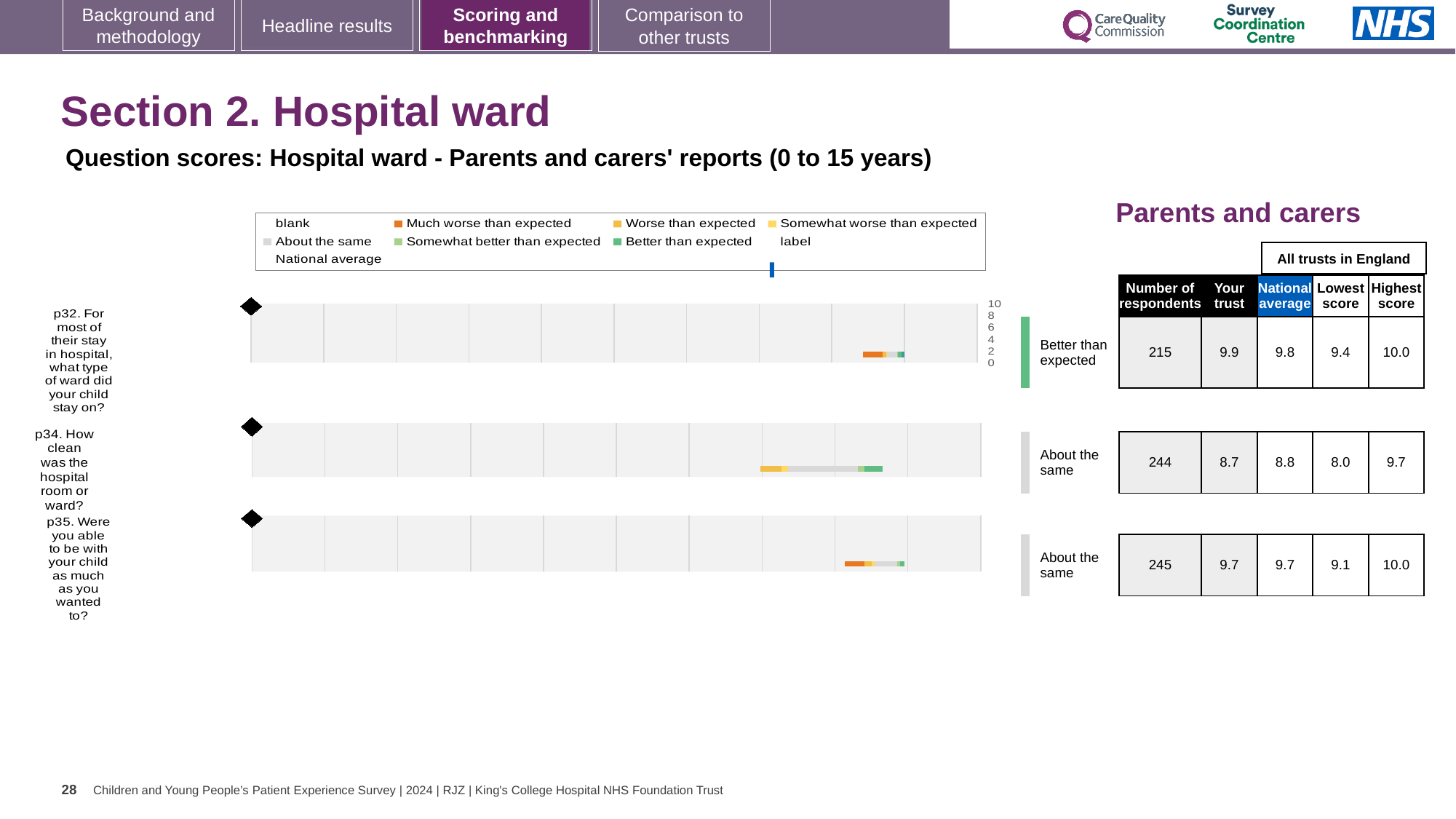
What benchmark category is shown for p32? Better than expected What kind of chart is used to show the question scores for p32, p34 and p35? bar chart For p32, which is larger: the 'Your trust' score or the national average? Your trust What is the national average score for p34 (How clean was the hospital room or ward?)? 8.8 Which question has the lowest 'Your trust' score? p34 Which question has the highest 'Your trust' score? p32 What benchmark category is shown for p35? About the same For p34, what is the difference between the highest score (9.7) and the lowest score (8.0) across all trusts in England? 1.7 What is the 'Your trust' score for p32 (For most of their stay in hospital, what type of ward did your child stay on?)? 9.9 How many respondents are recorded for p35 (Were you able to be with your child as much as you wanted to?)? 245 How many questions (p32, p34, p35) have a benchmark bar chart on this slide? 3 What is the lowest score across all trusts in England for p35? 9.1